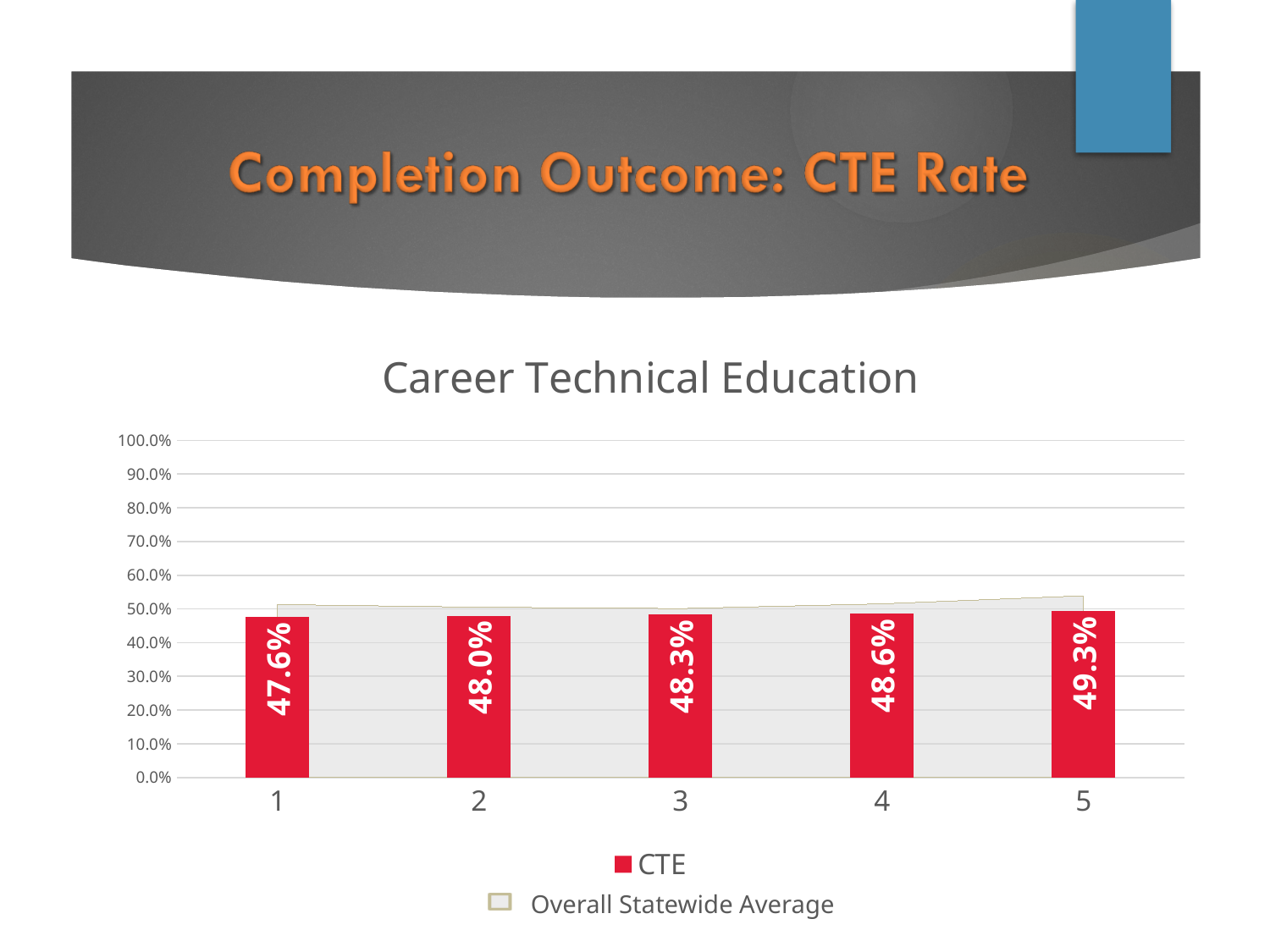
Which is larger, the CTE value for category 2 or for category 4? category 4 What is the CTE value for category 3? 48.3% Do the CTE values rise or fall from category 1 to category 5? rise What kind of chart is used to show the CTE series? bar chart Which category has the lowest CTE value? 1 Is the CTE value for category 3 greater or less than 50.0%? less How many categories are shown on the x axis? 5 What is the CTE value for category 1? 47.6% What is the CTE value for category 5? 49.3% How many series does the legend list? 2 Which category has the highest CTE value? 5 What is the difference between the CTE values for category 5 and category 1? 1.7%